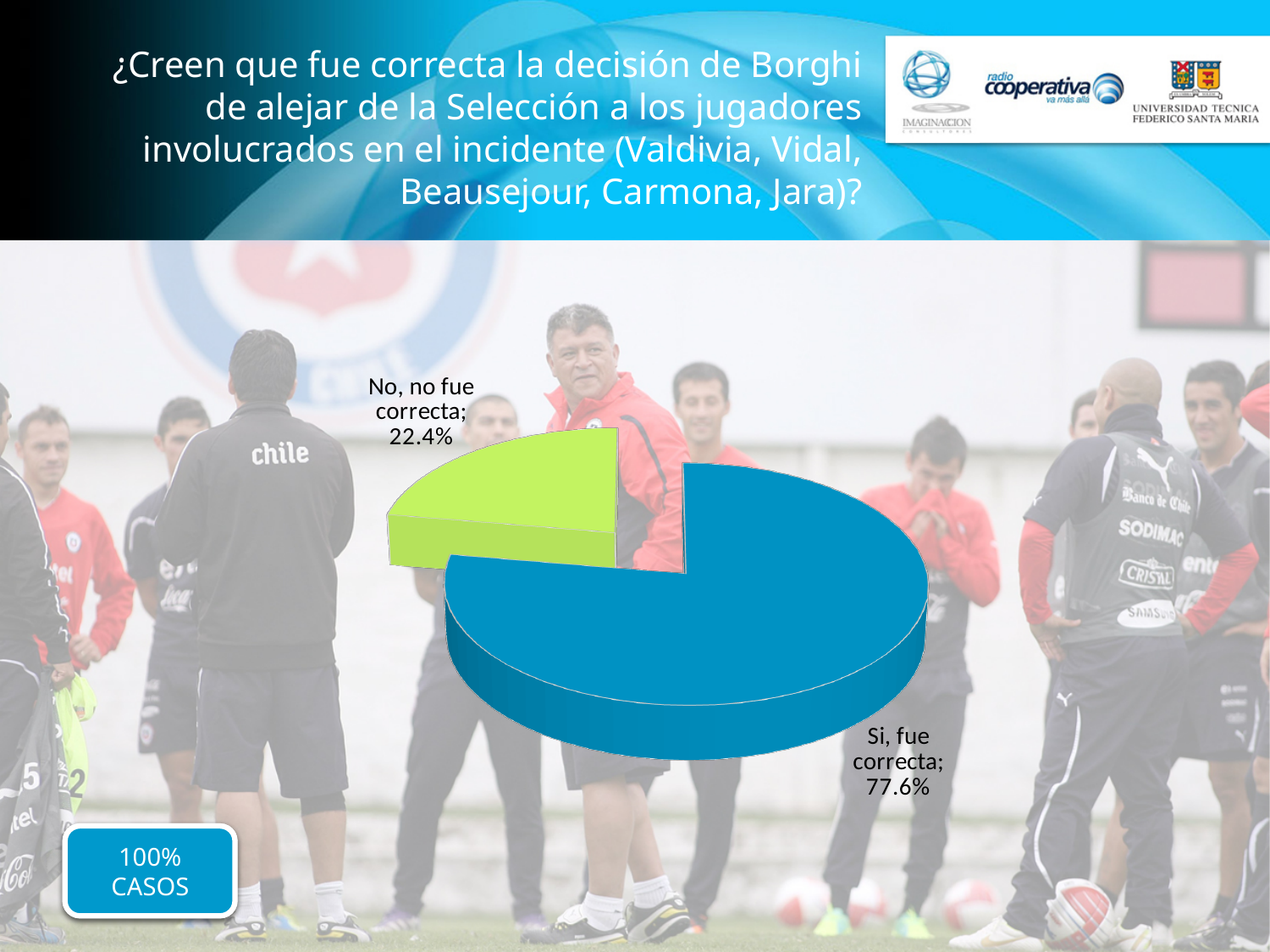
Which response has the smallest share of the pie? No, no fue correcta Which response has the largest share of the pie? Si, fue correcta What is the difference in percentage points between "Si, fue correcta" and "No, no fue correcta"? 55.2 What colour is the "Si, fue correcta" slice? Blue What percentage of respondents answered "Si, fue correcta"? 77.6% What kind of chart is shown on the slide? Pie chart What share of the pie does the "No, no fue correcta" slice represent? 22.4% What percentage of respondents answered "No, no fue correcta"? 22.4% How many slices does the pie chart have? 2 Which is larger: the share for "Si, fue correcta" or for "No, no fue correcta"? Si, fue correcta What colour is the "No, no fue correcta" slice? Green